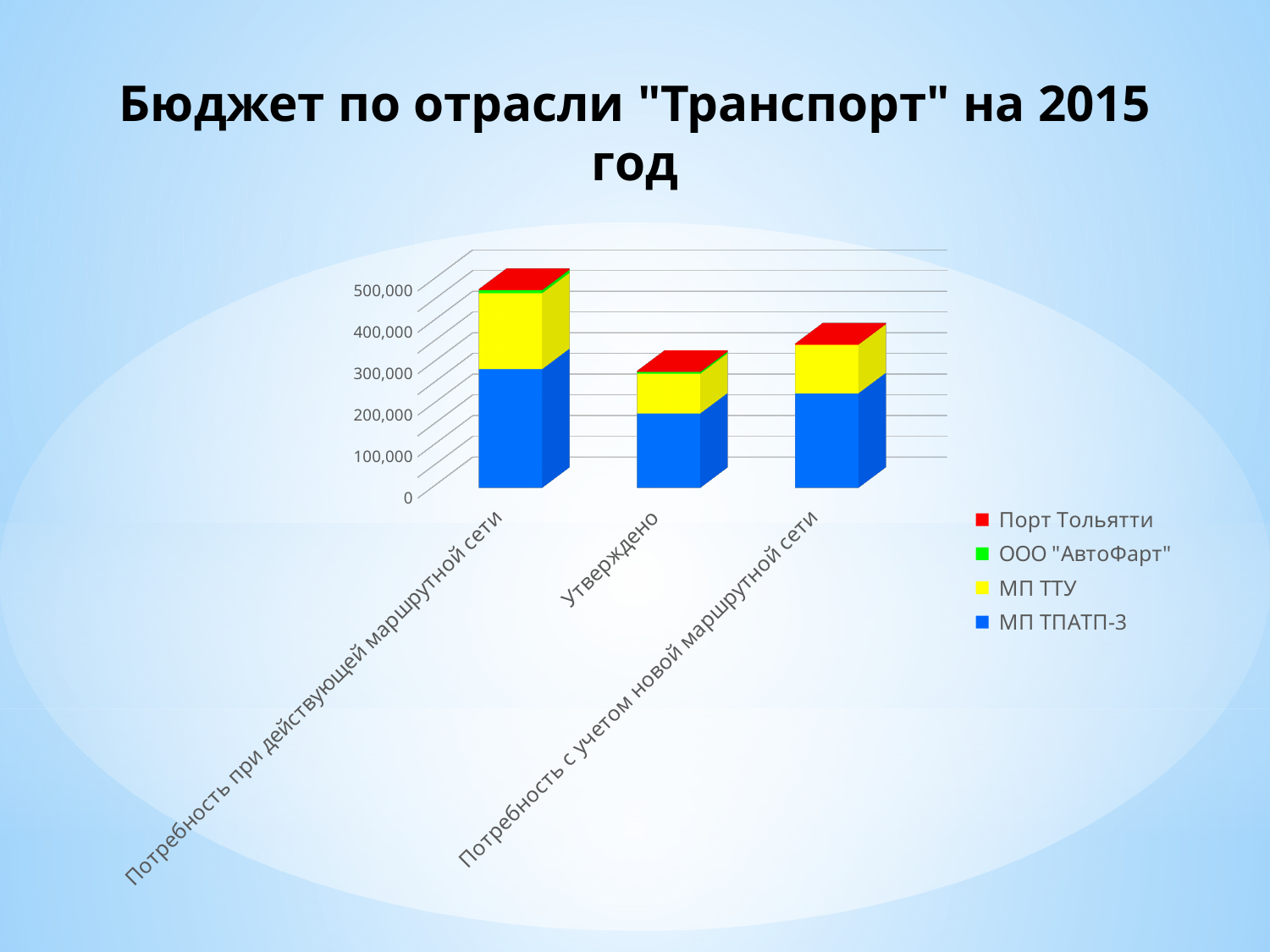
Which is larger, the total for "Утверждено" or the total for "Потребность с учетом новой маршрутной сети"? Потребность с учетом новой маршрутной сети Is the total value for "Потребность с учетом новой маршрутной сети" greater or less than 300,000? greater Which category has the lowest total bar? Утверждено How many categories are shown on the x axis? 3 Which series is shown in yellow in the legend? МП ТТУ What is the title of the chart? Бюджет по отрасли "Транспорт" на 2015 год Which category has the highest total bar? Потребность при действующей маршрутной сети Is the total value for "Утверждено" greater or less than 400,000? less Is the МП ТПАТП-3 value for "Потребность при действующей маршрутной сети" greater or less than 200,000? greater What kind of chart is shown on the slide? bar chart Which series forms the bottom segment of each stacked bar? МП ТПАТП-3 How many series does the legend list? 4